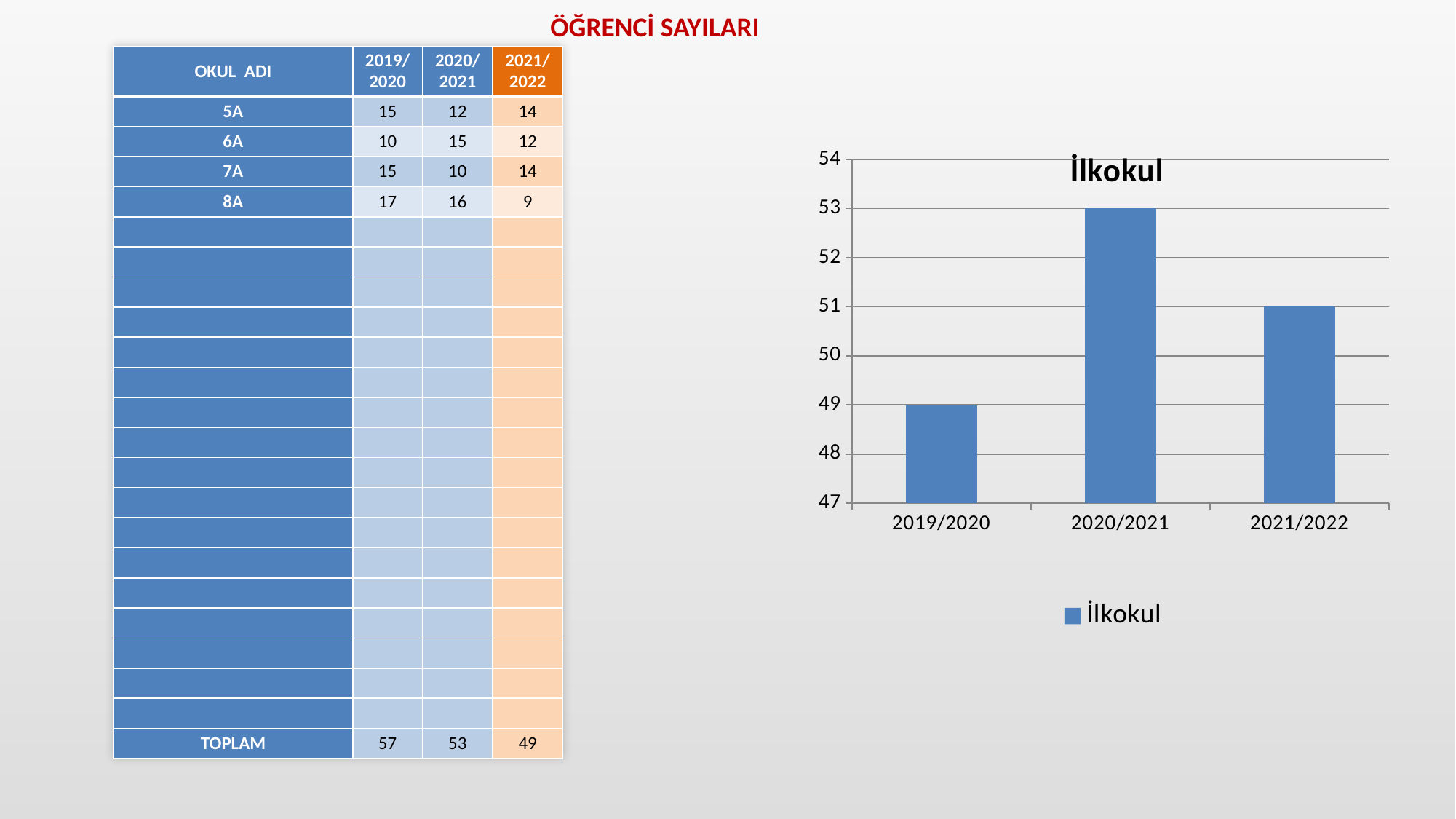
Which is larger in the İlkokul chart, the value for 2020/2021 or 2021/2022? 2020/2021 Which year has the highest value in the İlkokul chart? 2020/2021 Which year has the lowest value in the İlkokul chart? 2019/2020 What is the difference between the 2020/2021 and 2019/2020 values in the İlkokul chart? 4 What is the value for 2021/2022 in the İlkokul chart? 51 What is the value for 2020/2021 in the İlkokul chart? 53 What is the value for 2019/2020 in the İlkokul chart? 49 How many series does the legend of the İlkokul chart list? 1 Is the value for 2021/2022 in the İlkokul chart greater or less than 50? greater How many bars are shown in the İlkokul chart? 3 What type of chart is the İlkokul chart? bar chart What is the difference between the 2021/2022 and 2019/2020 values in the İlkokul chart? 2